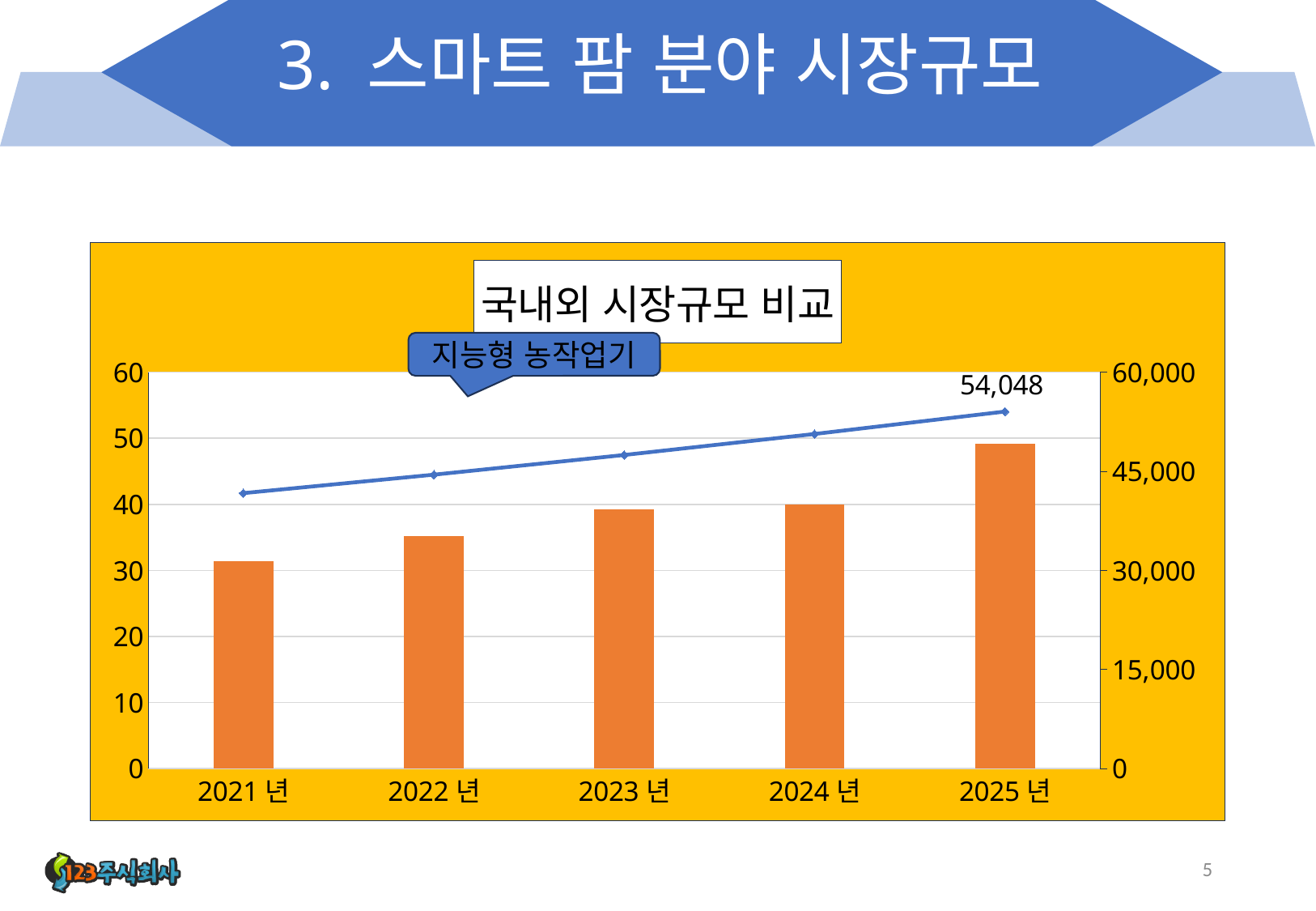
Do the bar values rise or fall from 2021 년 to 2025 년? rise What kind of chart is shown on the slide? A combined bar and line chart Is the bar value for 2022 년 greater or less than 30? greater Which year has the shortest bar? 2021 년 Is the bar value for 2025 년 greater or less than 40? greater Is the bar value for 2021 년 greater or less than 40? less What is the title of the chart? 국내외 시장규모 비교 What value is labelled on the line at 2025 년? 54,048 Which year has the tallest bar? 2025 년 How many years are shown on the x axis of the chart? 5 What label does the callout pointing to the line series show? 지능형 농작업기